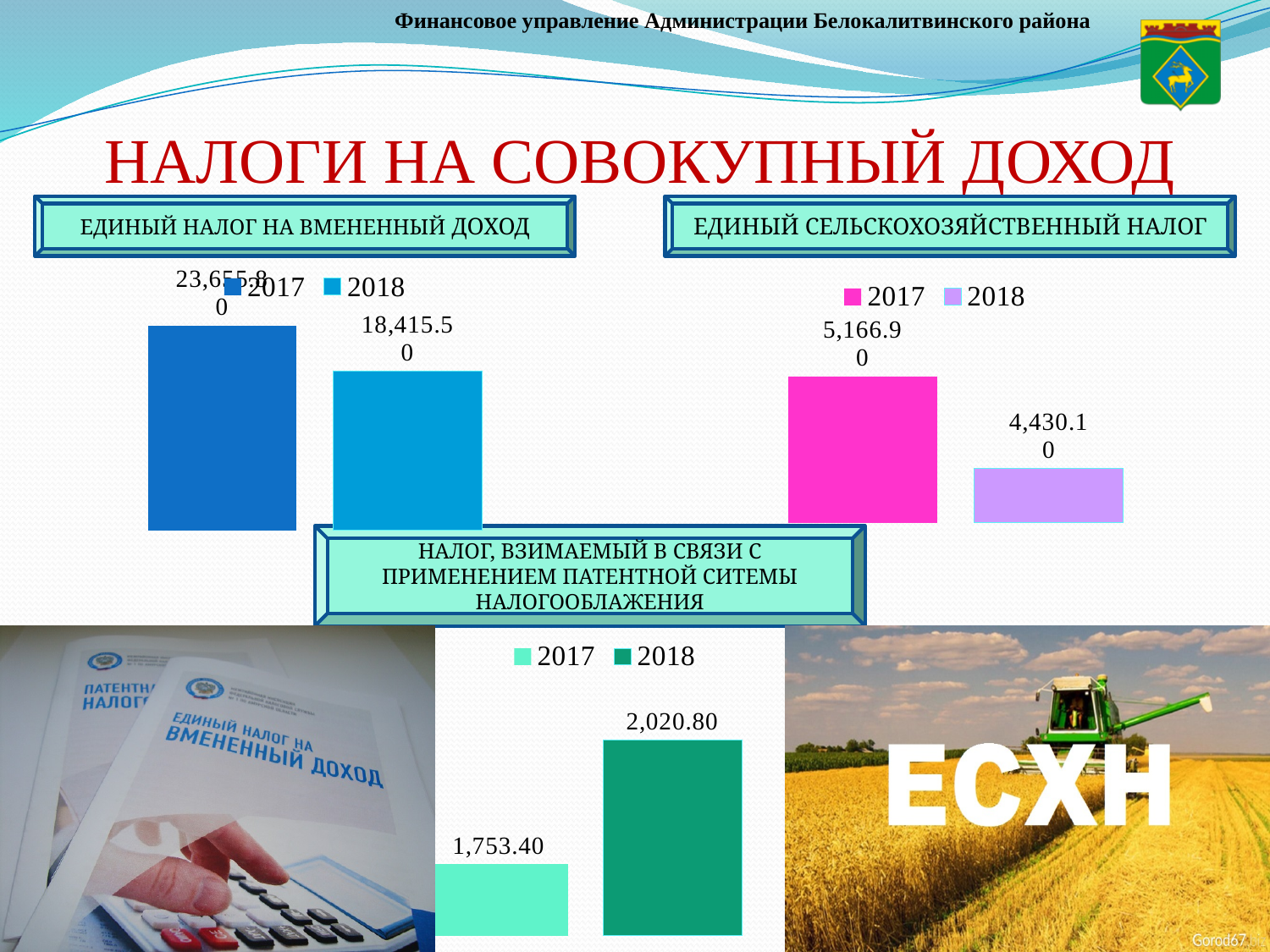
In the chart about the patent system tax (НАЛОГ, ВЗИМАЕМЫЙ В СВЯЗИ С ПРИМЕНЕНИЕМ ПАТЕНТНОЙ СИТЕМЫ НАЛОГООБЛАЖЕНИЯ), what is the value for 2017? 1,753.40 In the chart titled ЕДИНЫЙ НАЛОГ НА ВМЕНЕННЫЙ ДОХОД, which year has the higher value, 2017 or 2018? 2017 In the chart about the patent system tax (НАЛОГ, ВЗИМАЕМЫЙ В СВЯЗИ С ПРИМЕНЕНИЕМ ПАТЕНТНОЙ СИТЕМЫ НАЛОГООБЛАЖЕНИЯ), which year has the higher value? 2018 In the chart titled ЕДИНЫЙ СЕЛЬСКОХОЗЯЙСТВЕННЫЙ НАЛОГ, what is the value for 2018? 4,430.10 In the chart titled ЕДИНЫЙ СЕЛЬСКОХОЗЯЙСТВЕННЫЙ НАЛОГ, do the values rise or fall from 2017 to 2018? fall In the chart about the patent system tax (НАЛОГ, ВЗИМАЕМЫЙ В СВЯЗИ С ПРИМЕНЕНИЕМ ПАТЕНТНОЙ СИТЕМЫ НАЛОГООБЛАЖЕНИЯ), what is the value for 2018? 2,020.80 In the chart titled ЕДИНЫЙ НАЛОГ НА ВМЕНЕННЫЙ ДОХОД, how many series does the legend list? 2 In the chart titled ЕДИНЫЙ НАЛОГ НА ВМЕНЕННЫЙ ДОХОД, what is the value for 2018? 18,415.50 In the chart titled ЕДИНЫЙ СЕЛЬСКОХОЗЯЙСТВЕННЫЙ НАЛОГ, what is the difference between the 2017 and 2018 values? 736.80 In the chart titled ЕДИНЫЙ СЕЛЬСКОХОЗЯЙСТВЕННЫЙ НАЛОГ, what is the value for 2017? 5,166.90 In the chart about the patent system tax (НАЛОГ, ВЗИМАЕМЫЙ В СВЯЗИ С ПРИМЕНЕНИЕМ ПАТЕНТНОЙ СИТЕМЫ НАЛОГООБЛАЖЕНИЯ), what is the difference between the 2018 and 2017 values? 267.40 What type of chart is used for ЕДИНЫЙ СЕЛЬСКОХОЗЯЙСТВЕННЫЙ НАЛОГ? bar chart